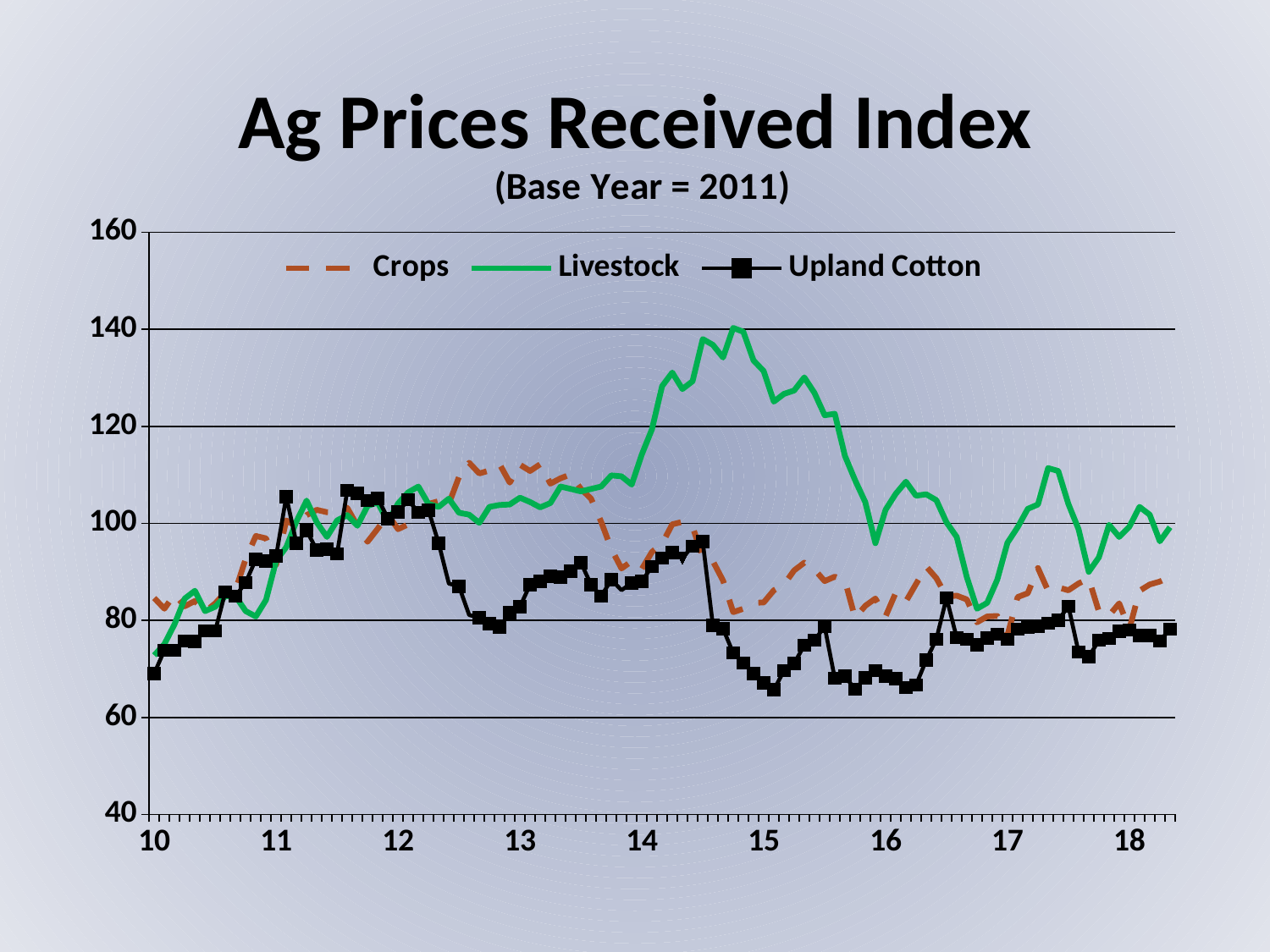
Is the peak value for Livestock around 2014-2015 greater or less than 120? greater What base year is stated in the chart subtitle? 2011 Which series reaches the lowest value on the chart? Upland Cotton At the start of 2013, which is larger, Crops or Upland Cotton? Crops Is the value for Crops at the start of 2013 greater or less than 100? greater How many series does the legend list? 3 Does the Livestock series rise or fall between 2015 and 2016? fall What kind of chart is shown on the slide? line chart Is the lowest value for Upland Cotton around 2015 greater or less than 80? less At the start of 2015, which is larger, Livestock or Upland Cotton? Livestock What is the title of the chart? Ag Prices Received Index Which series reaches the highest value on the chart? Livestock